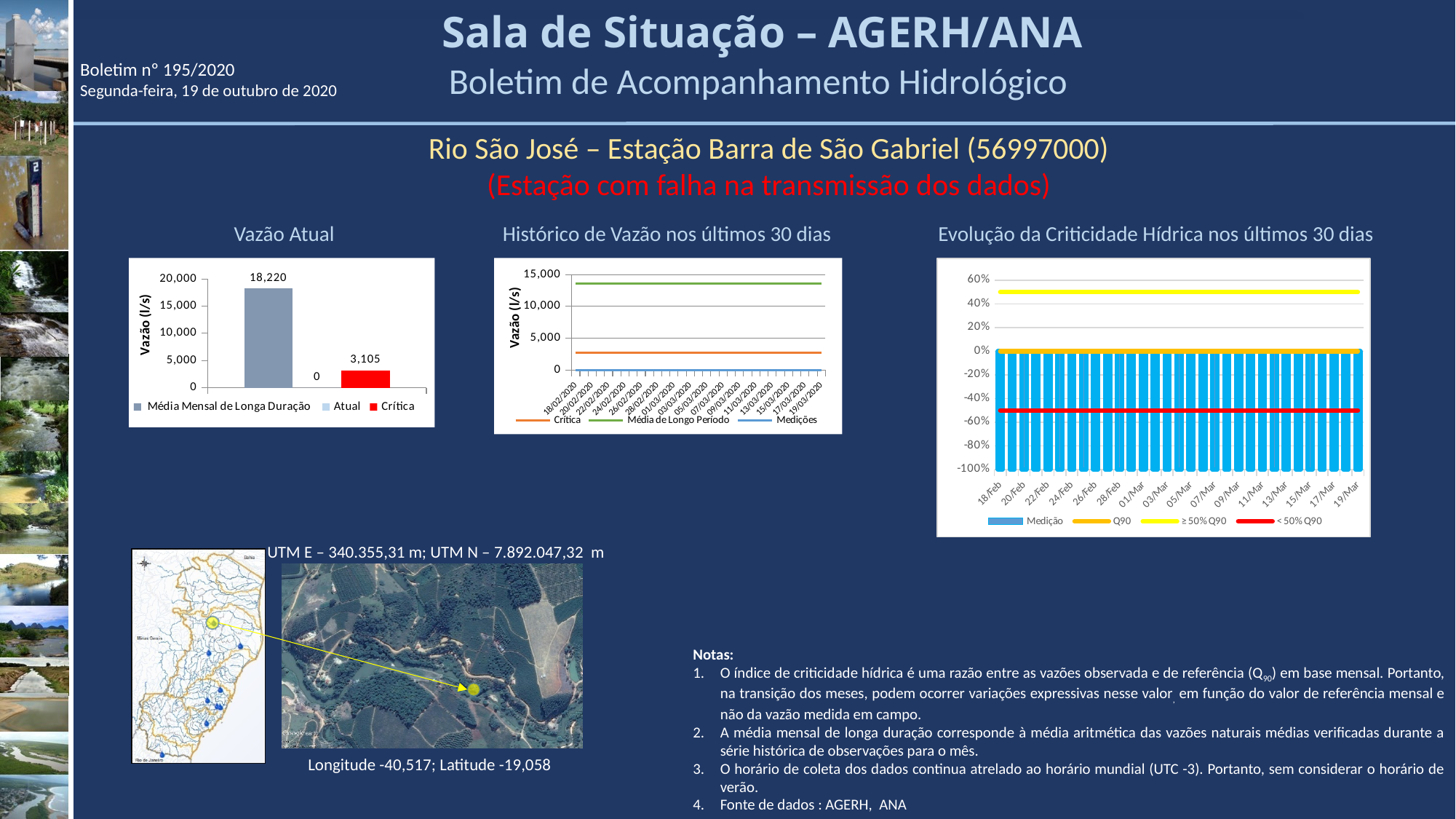
In the 'Evolução da Criticidade Hídrica nos últimos 30 dias' chart, what is the y-axis label of the lowest gridline? -100% In the 'Vazão Atual' chart, what is the value for Crítica? 3,105 In the 'Vazão Atual' chart, what is the value for Atual? 0 In the 'Vazão Atual' chart, which series has the highest value? Média Mensal de Longa Duração In the 'Histórico de Vazão nos últimos 30 dias' chart, how many series does the legend list? 3 In the 'Vazão Atual' chart, what is the value for Média Mensal de Longa Duração? 18,220 In the 'Vazão Atual' chart, how many series does the legend list? 3 In the 'Vazão Atual' chart, which series has the lowest value? Atual In the 'Histórico de Vazão nos últimos 30 dias' chart, is the Crítica line greater or less than 5,000? less What kind of chart is the 'Vazão Atual' chart? Bar chart In the 'Vazão Atual' chart, what is the difference between Média Mensal de Longa Duração and Crítica? 15,115 In the 'Histórico de Vazão nos últimos 30 dias' chart, is the Média de Longo Período line greater or less than 10,000? greater